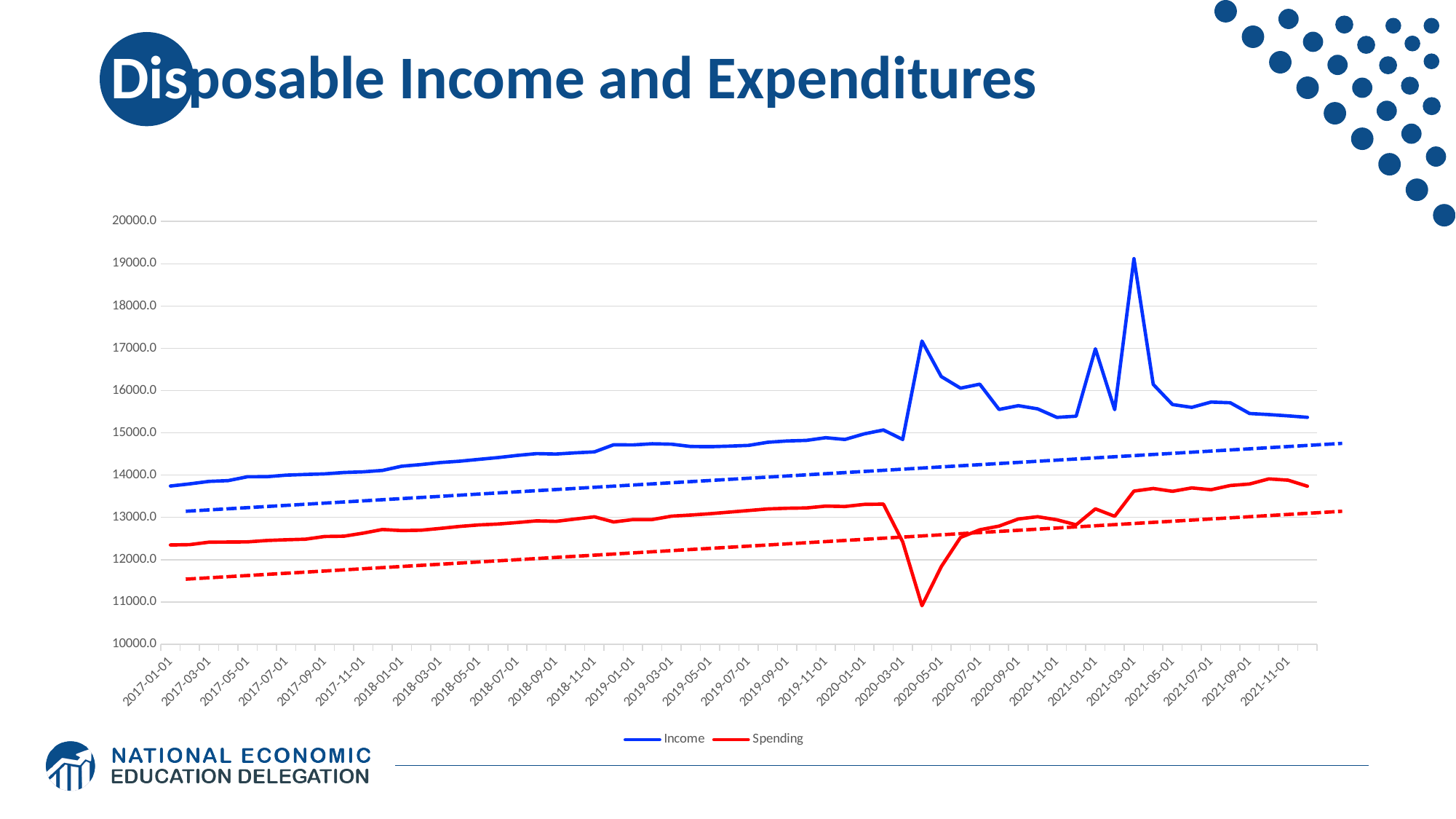
Does the Income line generally rise or fall from 2017-01-01 to 2019-11-01? rise How many series does the legend list? 2 Is the peak value of Income around 2021-03-01 greater or less than 18000.0? greater Is the value for Spending at 2017-01-01 greater or less than 12000.0? greater What is the title of the chart on the slide? Disposable Income and Expenditures Which series is higher at 2019-01-01, Income or Spending? Income What kind of chart is shown on the slide? line chart What colour is the Income line in the chart? blue Which series reaches the highest value anywhere on the chart? Income Is the value for Income at 2017-01-01 greater or less than 14000.0? less